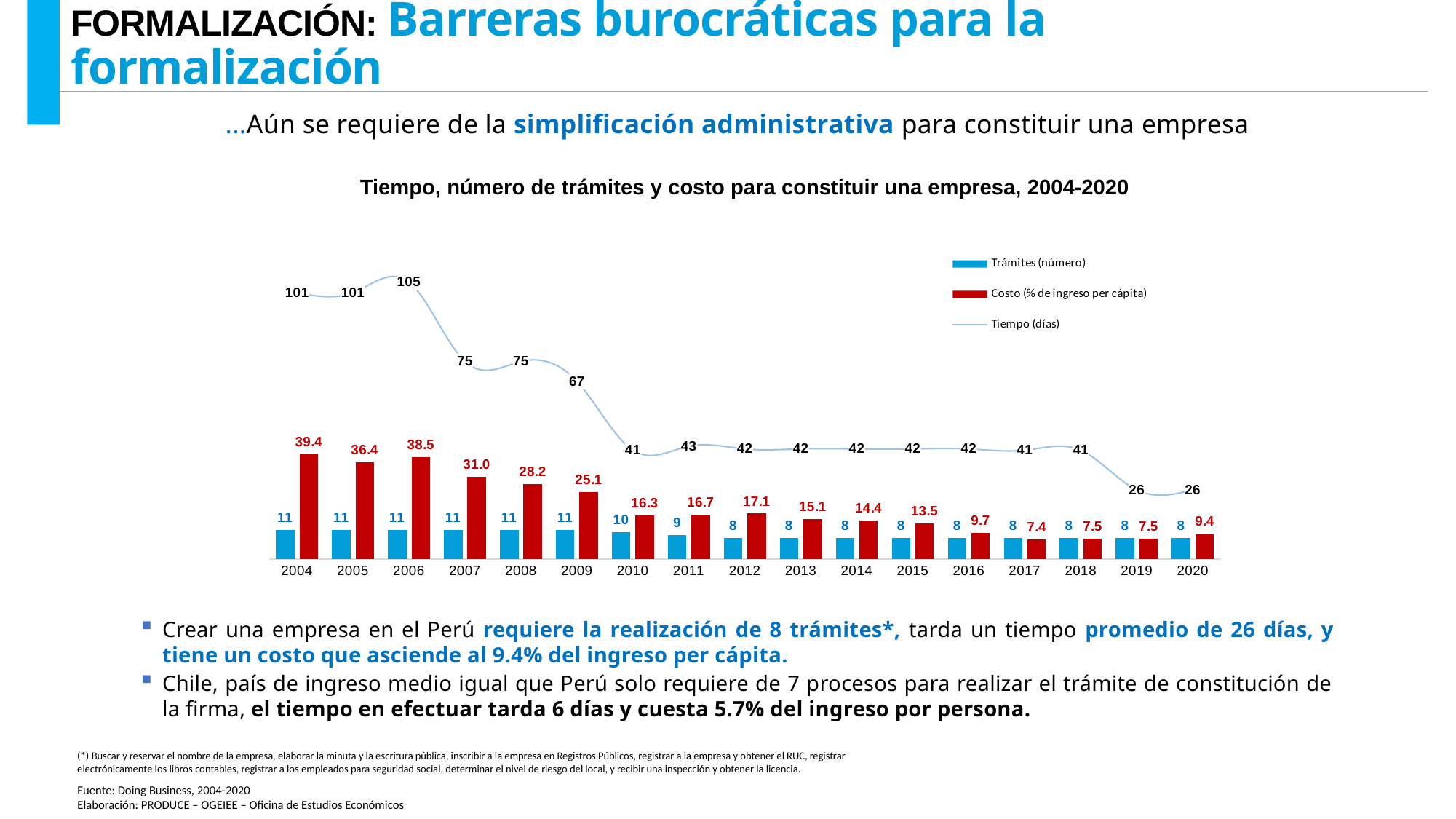
What is the value of Costo (% de ingreso per cápita) for 2004? 39.4 How many years are shown on the x axis of the chart? 17 In which year is Costo (% de ingreso per cápita) highest? 2004 What is the value of Trámites (número) for 2020? 8 What is the title of the chart? Tiempo, número de trámites y costo para constituir una empresa, 2004-2020 What kind of chart is shown on the slide? Combined bar and line chart What is the difference between the Tiempo (días) values for 2004 and 2020? 75 How many series does the legend list? 3 Does the Tiempo (días) series generally rise or fall from 2004 to 2020? Fall Which is larger, the Costo (% de ingreso per cápita) value for 2010 or for 2012? 2012 In which year is Costo (% de ingreso per cápita) lowest? 2017 What is the value of Tiempo (días) for 2006? 105